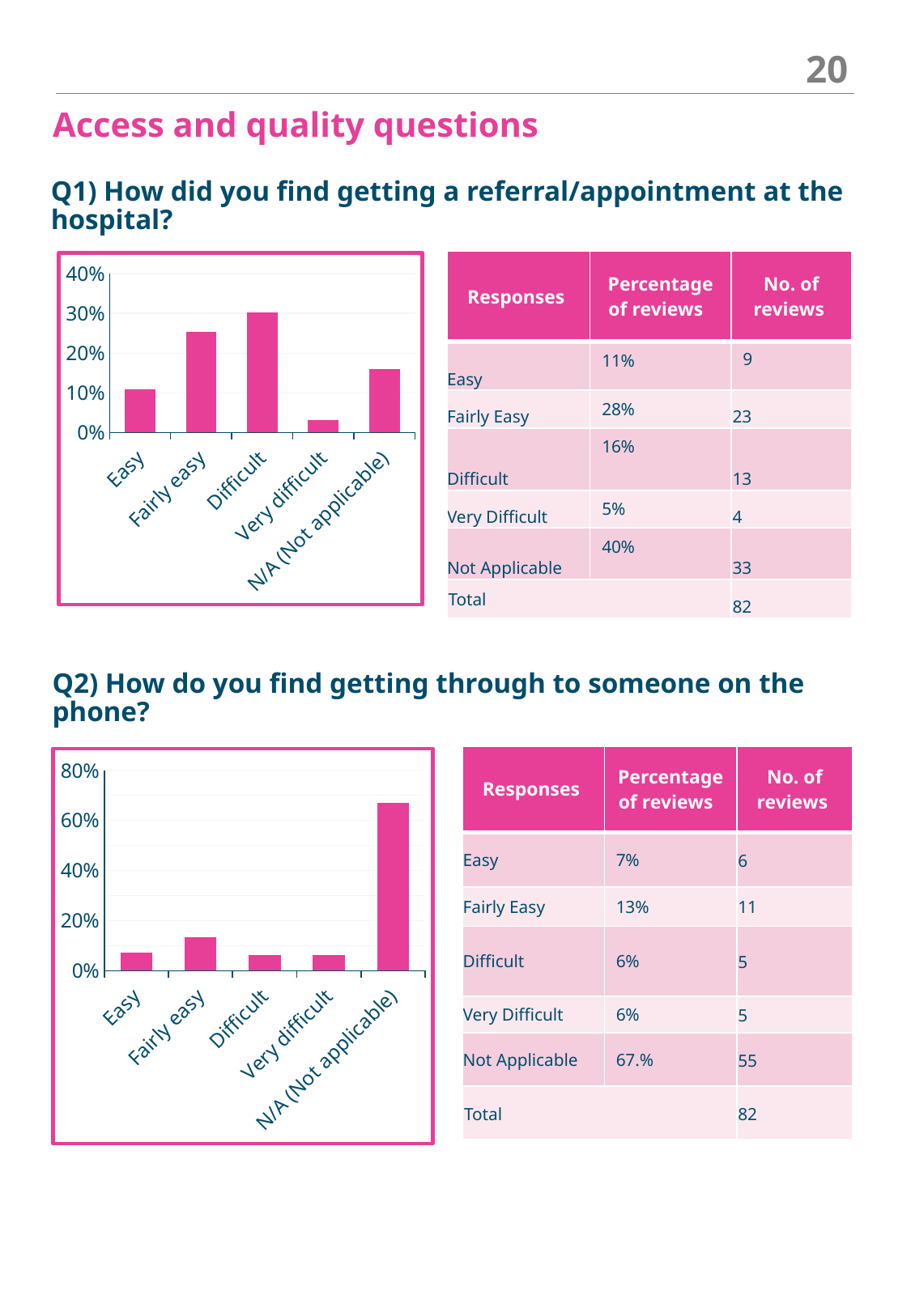
In the top chart (Q1, referral/appointment), which is larger, the value for Fairly easy or the value for Easy? Fairly easy In the bottom chart (Q2, getting through on the phone), is the value for Fairly easy greater or less than 20%? less In the top chart (Q1, referral/appointment), which category has the lowest bar? Very difficult In the bottom chart (Q2, getting through on the phone), which is larger, the value for Fairly easy or the value for Easy? Fairly easy In the top chart (Q1, referral/appointment), is the value for Very difficult greater or less than 10%? less In the bottom chart (Q2, getting through on the phone), which category has the highest bar? N/A (Not applicable) In the top chart (Q1, referral/appointment), which category has the highest bar? Difficult In the bottom chart (Q2, getting through on the phone), is the value for N/A (Not applicable) greater or less than 60%? greater How many categories are shown on the x axis of the top chart (Q1)? 5 What kind of chart is the bottom chart (Q2)? bar chart